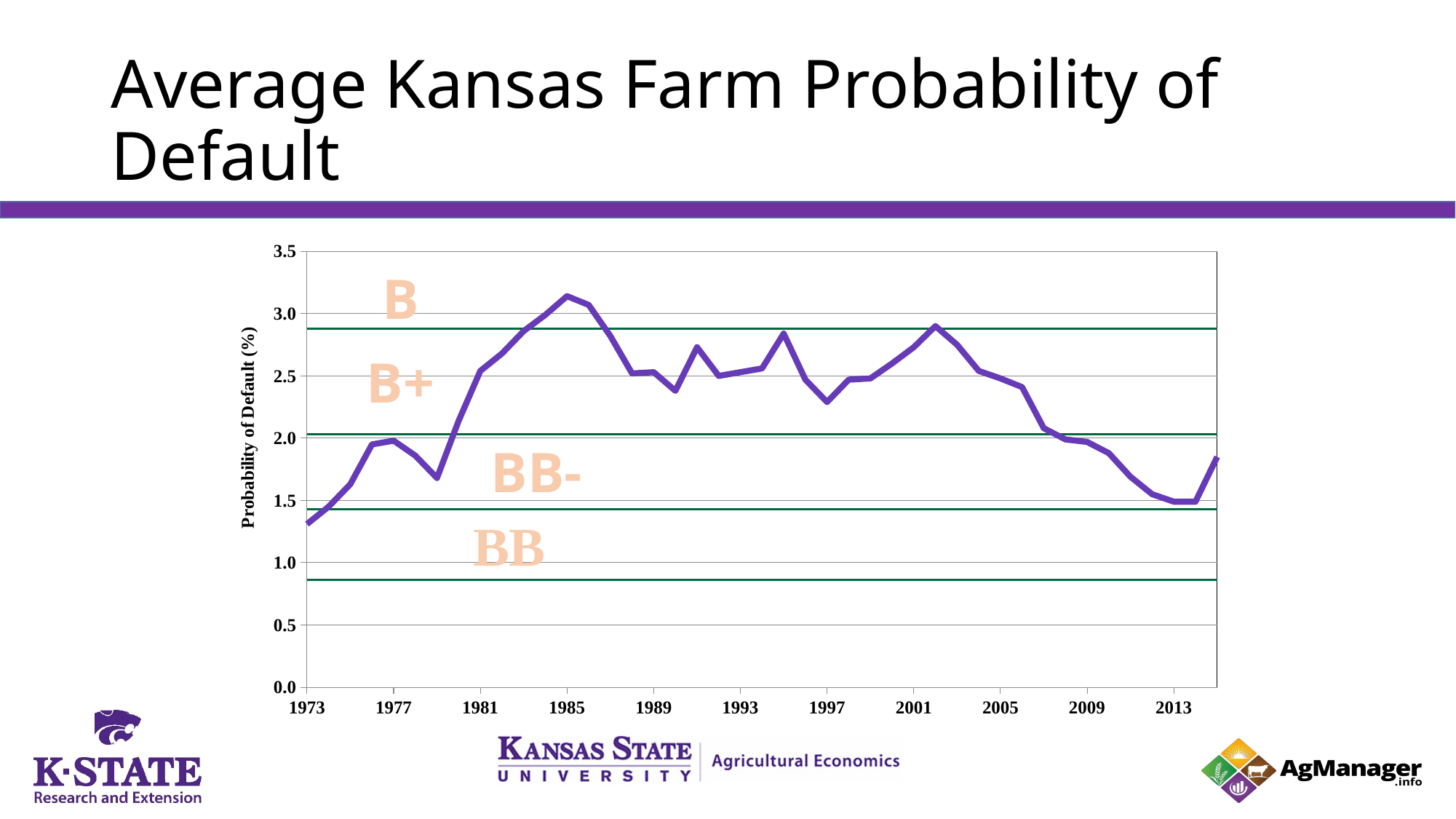
Is the probability of default in 2001 greater or less than 2.5? greater Is the probability of default in 1985 greater or less than 3.0? greater Is the probability of default in 2013 greater or less than 2.0? less Does the probability of default rise or fall between 2002 and 2013? fall Does the probability of default rise or fall between 1973 and 1985? rise In which year is the average Kansas farm probability of default at its lowest? 1973 What kind of chart is shown on the slide? line chart Which credit rating label is shown in the band between the top two horizontal reference lines? B+ What is the label on the vertical axis of the chart? Probability of Default (%) In which year does the average Kansas farm probability of default reach its highest value? 1985